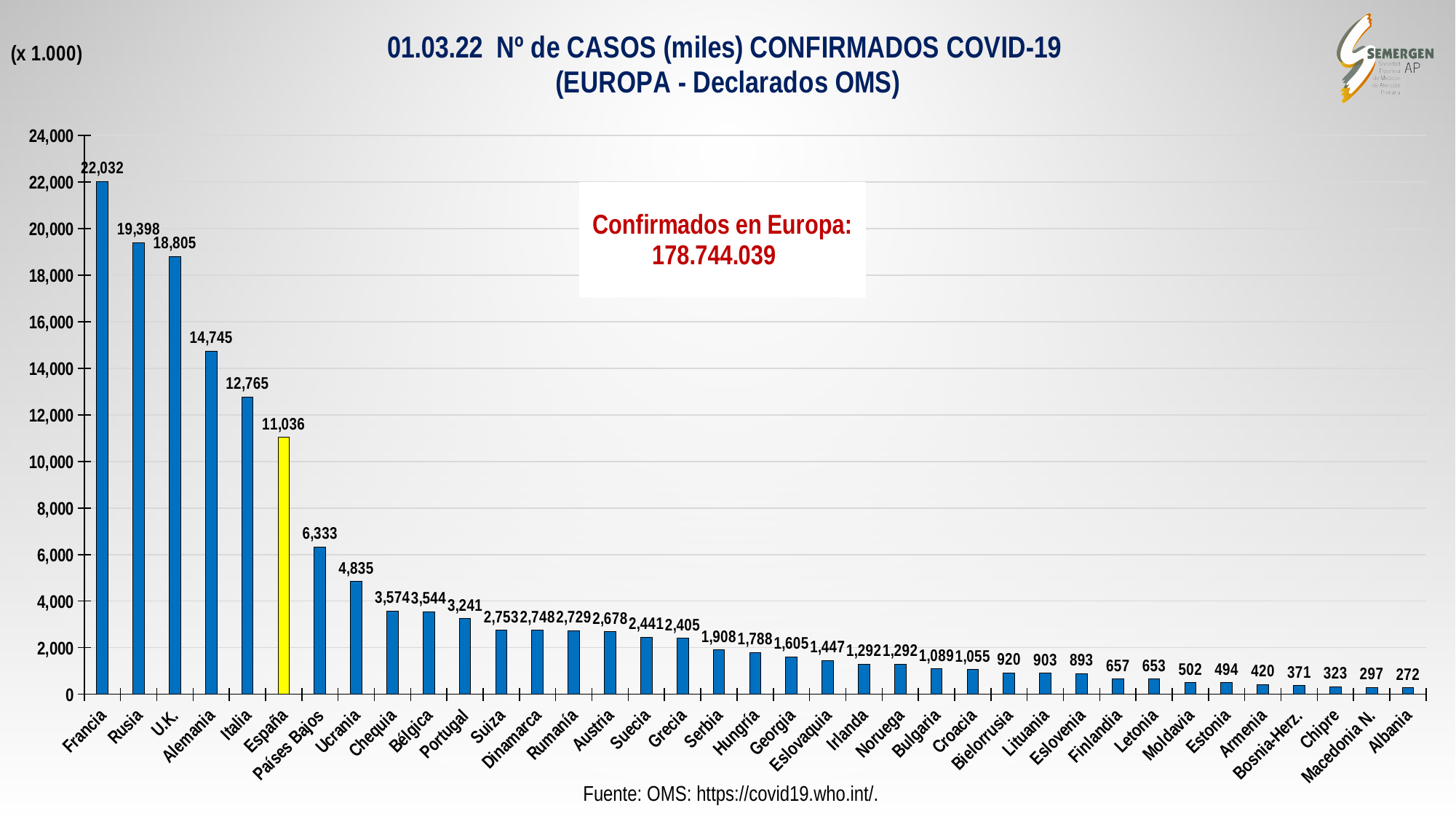
Which country has the lowest value on the chart? Albania What is the difference between the values for Francia and Rusia? 2,634 What is the value shown for España? 11,036 What is the value shown for Ucrania? 4,835 Do the values rise or fall from left to right along the x axis? Fall What is the difference between the values for España and Países Bajos? 4,703 Which country has the highest value on the chart? Francia What kind of chart is shown on the slide? Bar chart Which has a larger value, Alemania or Italia? Alemania What is the value shown for Albania? 272 How many countries are shown on the chart? 37 Which country's bar is highlighted in yellow? España